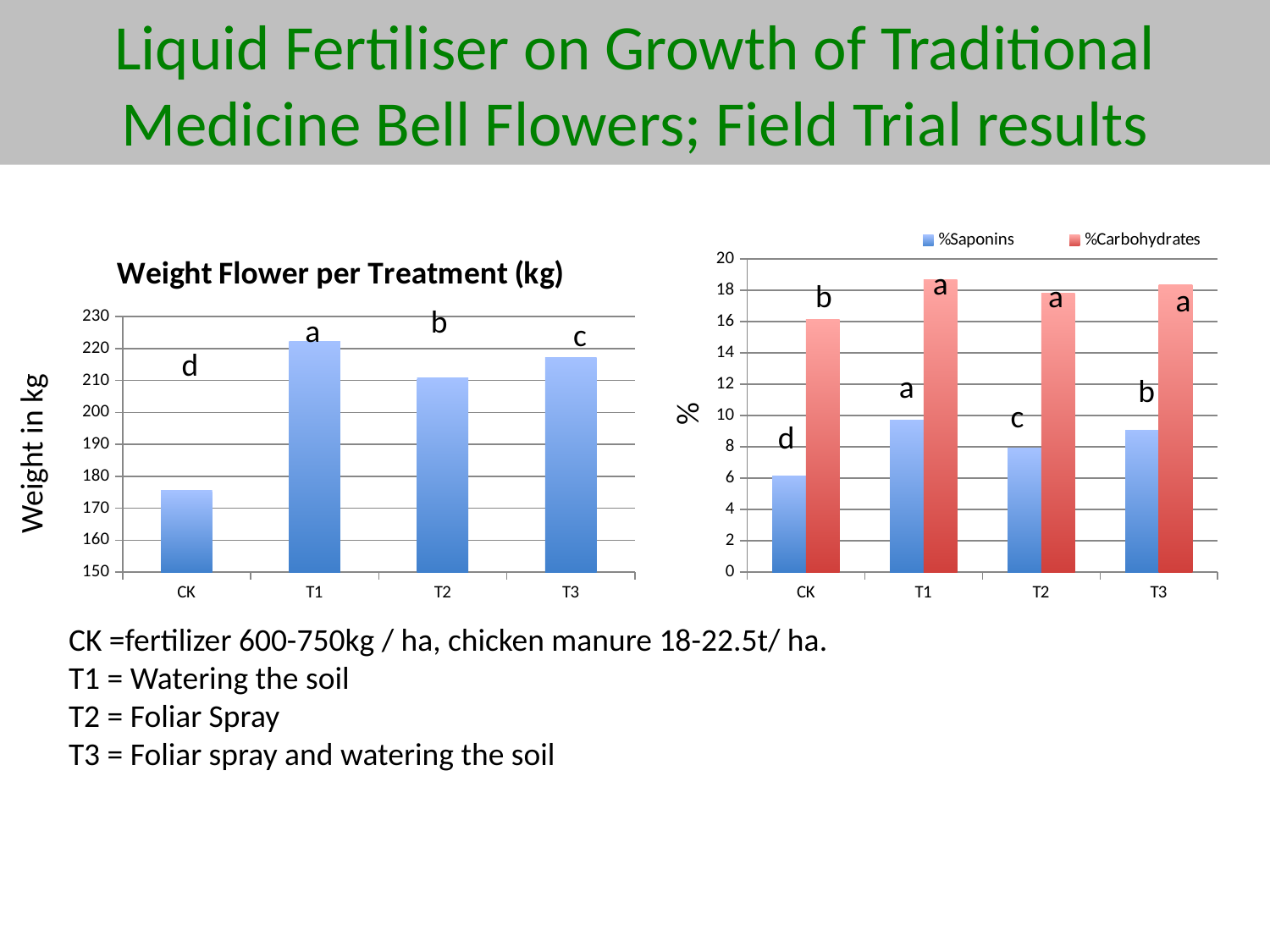
On the right chart, which treatment has the highest %Saponins value? T1 On the left chart titled "Weight Flower per Treatment (kg)", which treatment has the highest flower weight? T1 On the left chart titled "Weight Flower per Treatment (kg)", is the value for CK greater or less than 180? less On the left chart titled "Weight Flower per Treatment (kg)", is the value for T3 greater or less than 210? greater On the right chart, which is larger: the %Saponins value for T2 or for T3? T3 On the right chart, which treatment has the lowest %Carbohydrates value? CK On the right chart, is the %Carbohydrates value for T1 greater or less than 18? greater On the left chart titled "Weight Flower per Treatment (kg)", which treatment has the lowest flower weight? CK On the left chart titled "Weight Flower per Treatment (kg)", how many treatments are shown on the x axis? 4 On the right chart, how many series does the legend list? 2 What kind of chart is the left chart titled "Weight Flower per Treatment (kg)"? bar chart